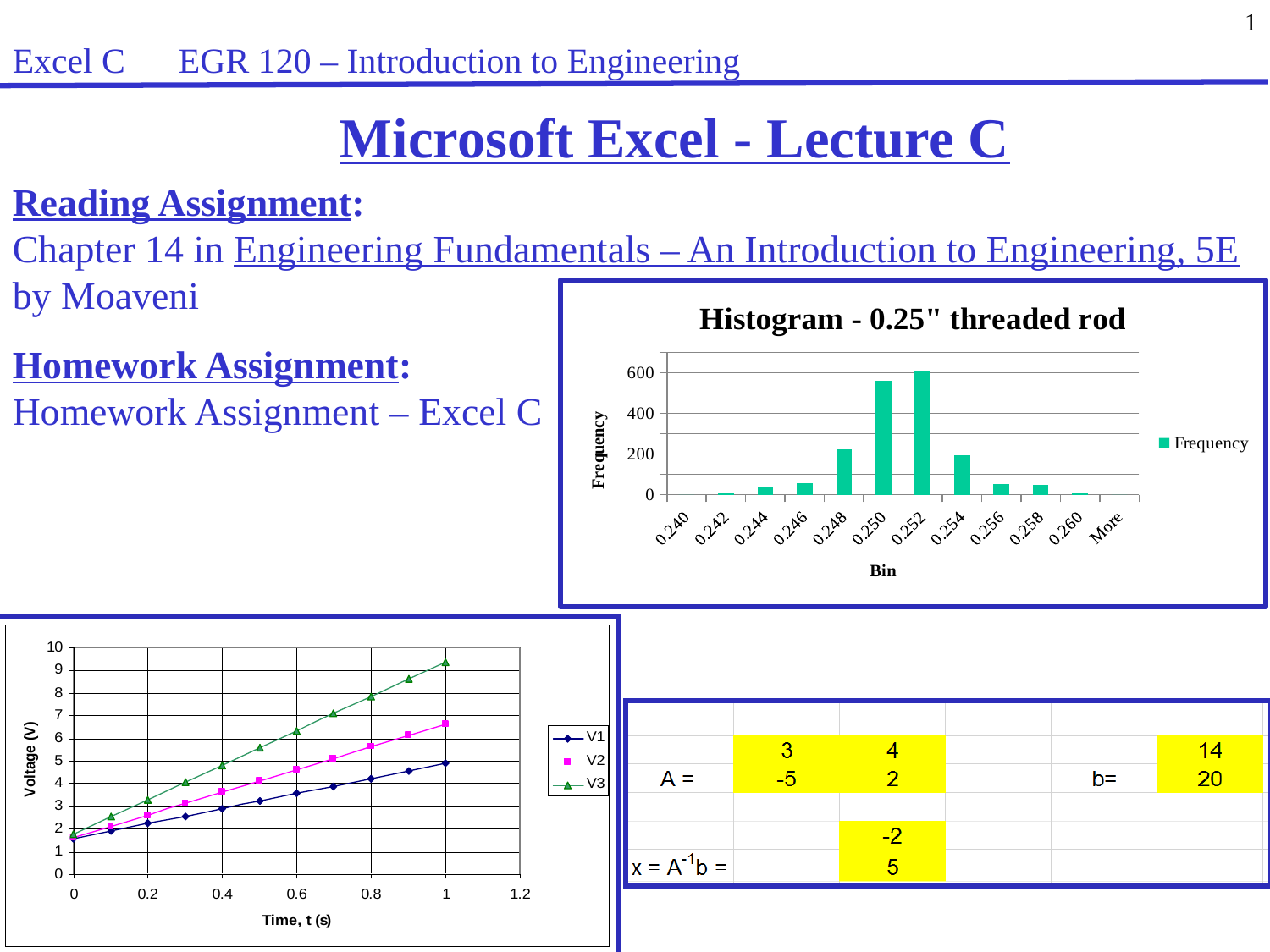
In the 'Histogram - 0.25" threaded rod' chart, which bin has the higher frequency, 0.250 or 0.256? 0.250 In the 'Histogram - 0.25" threaded rod' chart, how many bins are shown on the x axis? 12 In the 'Histogram - 0.25" threaded rod' chart, what is the label of the y axis? Frequency What kind of chart is the Voltage vs Time chart at the bottom left? line chart What kind of chart is the 'Histogram - 0.25" threaded rod' chart? bar chart In the Voltage vs Time chart, do the voltage values rise or fall as time increases? rise In the Voltage vs Time chart, is the value of V3 at t = 1 s greater or less than 9? greater How many series does the legend of the Voltage vs Time chart list? 3 In the 'Histogram - 0.25" threaded rod' chart, is the frequency for bin 0.246 greater or less than 200? less In the 'Histogram - 0.25" threaded rod' chart, which bin has the highest frequency? 0.252 In the Voltage vs Time chart, which series has the highest voltage at t = 1 s? V3 In the 'Histogram - 0.25" threaded rod' chart, is the frequency for bin 0.250 greater or less than 400? greater